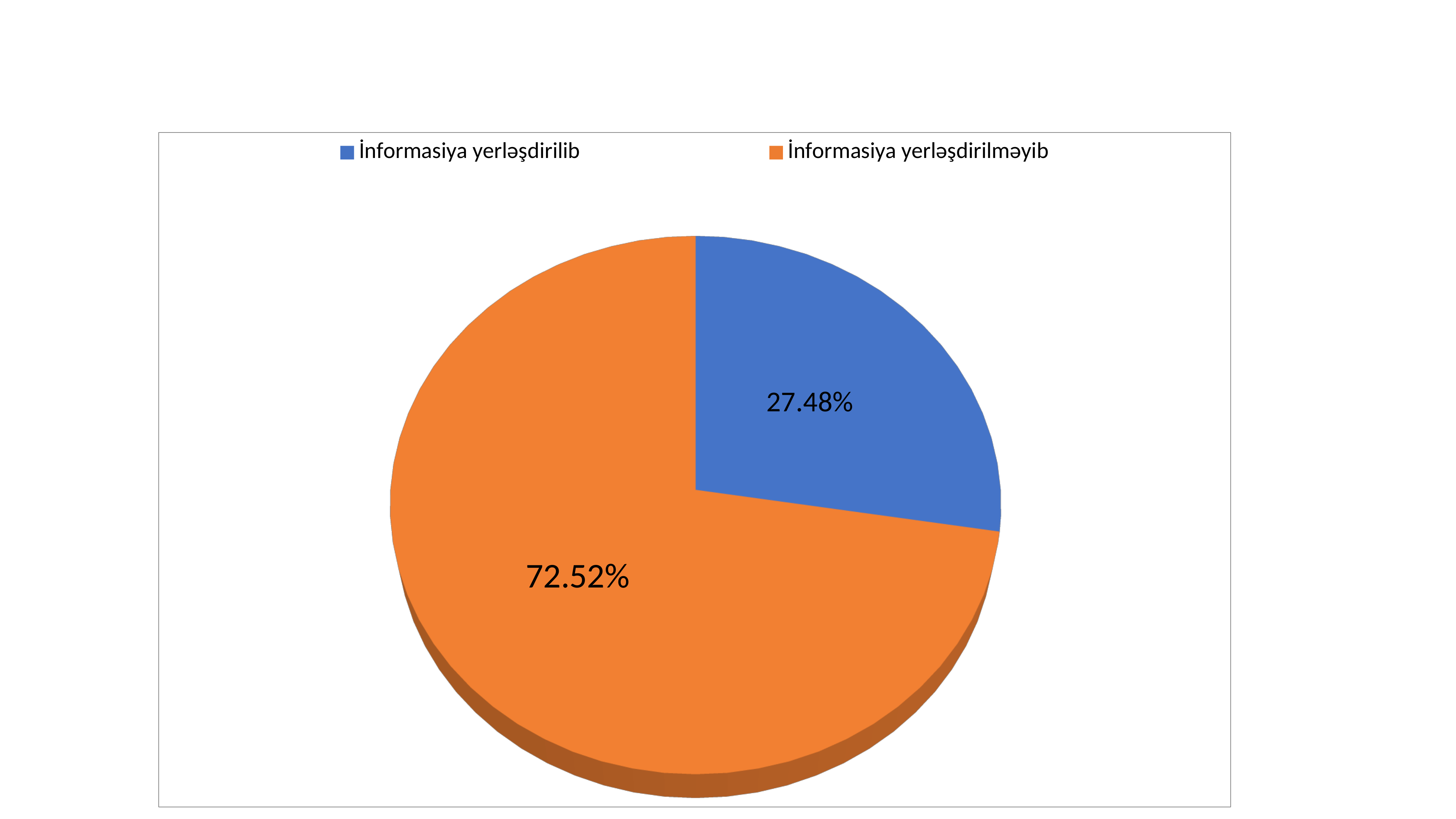
What is the value for İnformasiya yerləşdirilməyib? 72.52% How many slices does the pie chart have? 2 What share of the pie does İnformasiya yerləşdirilib take? 27.48% Which is larger, İnformasiya yerləşdirilib or İnformasiya yerləşdirilməyib? İnformasiya yerləşdirilməyib What colour is the İnformasiya yerləşdirilməyib slice? Orange What is the difference between the İnformasiya yerləşdirilməyib and İnformasiya yerləşdirilib slices? 45.04% Which category has the largest slice? İnformasiya yerləşdirilməyib What is the value for İnformasiya yerləşdirilib? 27.48% What kind of chart is shown on the slide? Pie chart Which category has the smallest slice? İnformasiya yerləşdirilib What colour is the İnformasiya yerləşdirilib slice? Blue How many entries does the legend list? 2